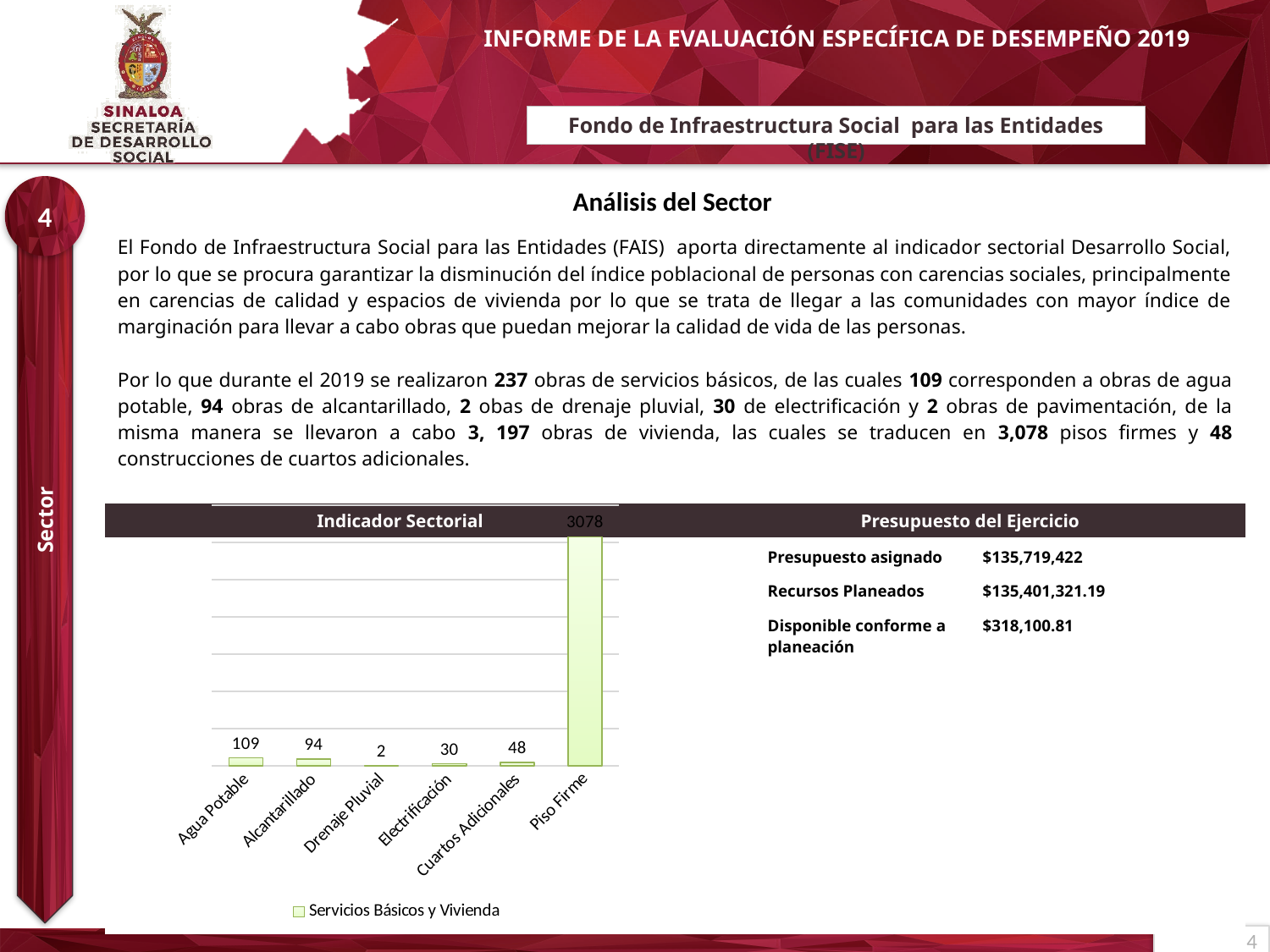
Which is larger, the value for Electrificación or the value for Cuartos Adicionales? Cuartos Adicionales What is the difference between the values for Agua Potable and Alcantarillado? 15 What is the value for Electrificación in the chart? 30 Which category has the highest value in the chart? Piso Firme What is the value for Agua Potable in the chart? 109 What is the value for Cuartos Adicionales in the chart? 48 What is the legend entry of the chart? Servicios Básicos y Vivienda What kind of chart is shown on the slide? Bar chart How many series does the chart legend list? 1 How many categories are shown on the x axis of the chart? 6 What is the value for Piso Firme in the chart? 3078 Which category has the lowest value in the chart? Drenaje Pluvial